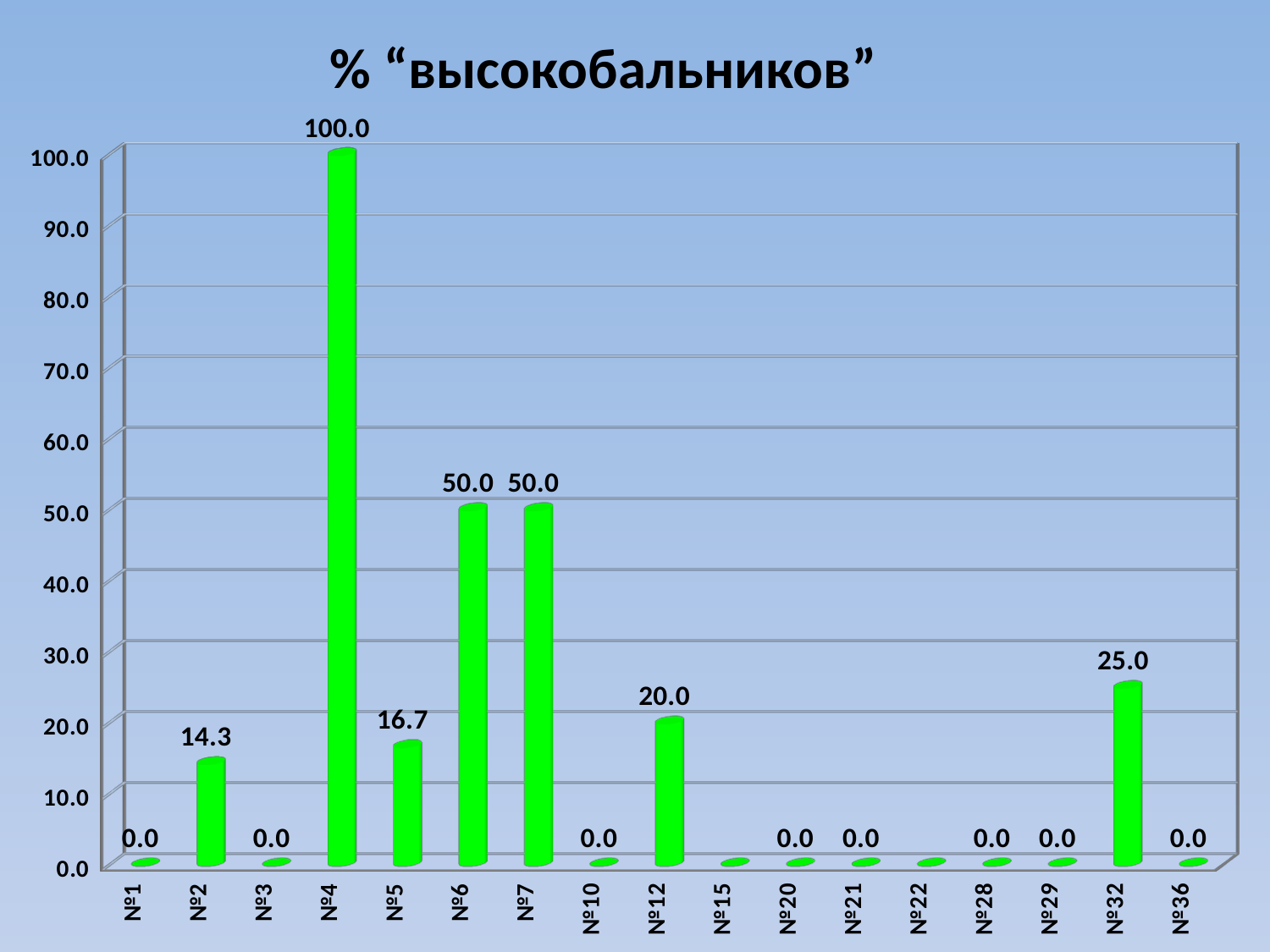
What is the value for №4? 100.0 Is the value for №7 greater or less than 40.0? greater What is the value for №32? 25.0 What is the value for №2? 14.3 What is the value for №12? 20.0 Which category has the highest value? №4 How many categories are shown on the x axis? 17 What is the difference between the values for №32 and №5? 8.3 What is the difference between the values for №4 and №6? 50.0 Which is larger, the value for №5 or the value for №12? №12 What kind of chart is shown on the slide? bar chart What is the title of the chart? % “высокобальников”